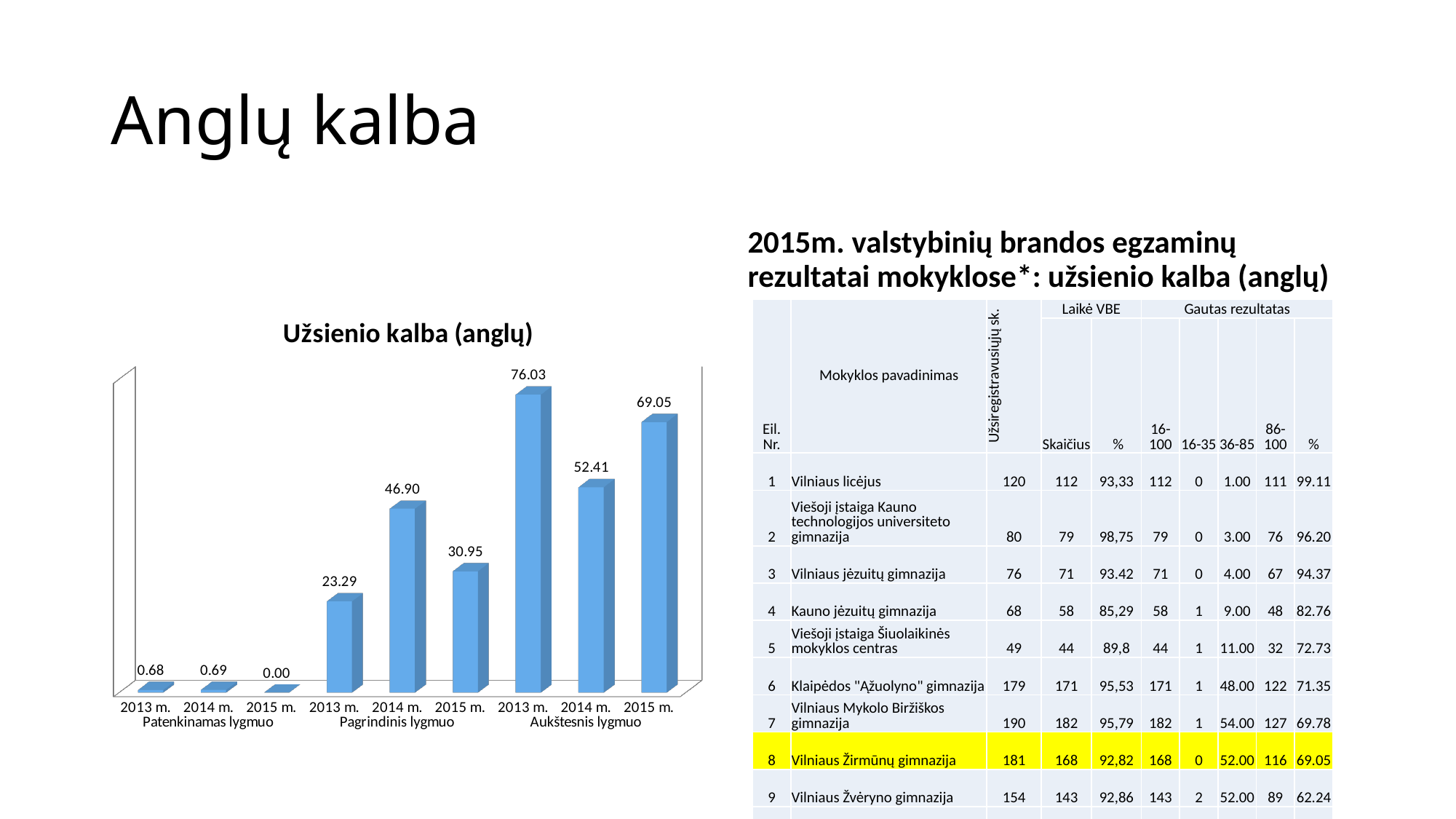
What is the difference between the 2013 m. and 2014 m. values in the Aukštesnis lygmuo group? 23.62 What is the title of the chart? Užsienio kalba (anglų) What is the value for 2015 m. in the Pagrindinis lygmuo group? 30.95 Which bar has the highest value on the chart? 2013 m. (Aukštesnis lygmuo) What is the value for 2014 m. in the Pagrindinis lygmuo group? 46.90 Which is larger: the 2015 m. value in the Pagrindinis lygmuo group or the 2014 m. value in the Aukštesnis lygmuo group? 2014 m. in Aukštesnis lygmuo Which bar has the lowest value on the chart? 2015 m. (Patenkinamas lygmuo) What is the value for 2015 m. in the Aukštesnis lygmuo group? 69.05 What is the difference between the 2014 m. and 2013 m. values in the Pagrindinis lygmuo group? 23.61 What type of chart is shown on the slide? Bar chart What is the value for 2013 m. in the Patenkinamas lygmuo group? 0.68 How many bars are plotted on the chart? 9